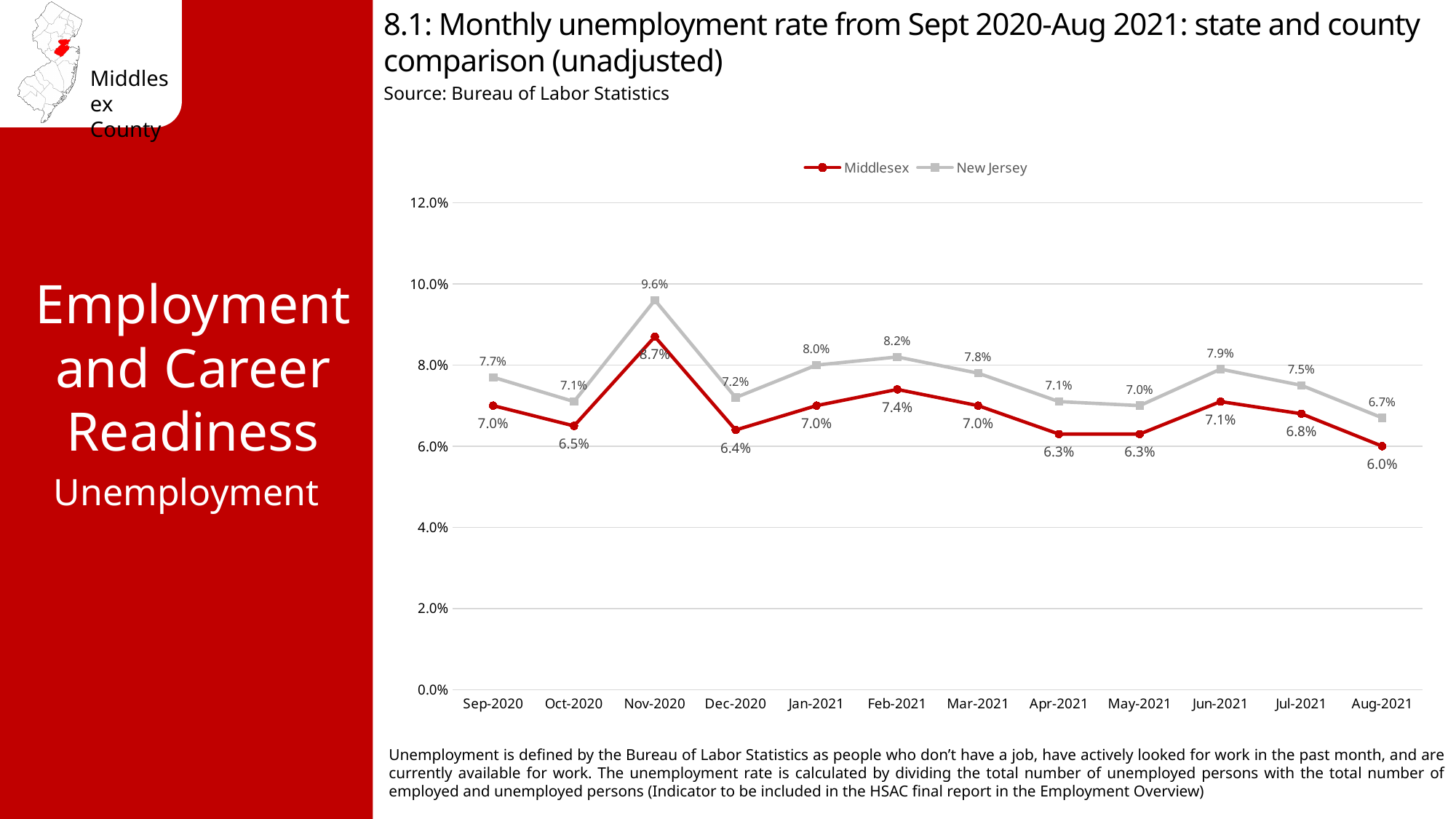
In which month does the New Jersey unemployment rate reach its highest value? Nov-2020 Is the New Jersey unemployment rate in Nov-2020 greater or less than 8.0%? greater What is the unemployment rate for Middlesex in Feb-2021? 7.4% How many months are shown on the x axis? 12 What is the unemployment rate for New Jersey in Jan-2021? 8.0% Does the Middlesex unemployment rate rise or fall from Jun-2021 to Aug-2021? Fall What is the unemployment rate for Middlesex in Aug-2021? 6.0% Which series has the higher unemployment rate in Mar-2021, Middlesex or New Jersey? New Jersey What is the difference between the New Jersey and Middlesex unemployment rates in Sep-2020? 0.7% What type of chart is shown on the slide? Line chart How many series does the legend list? 2 In which month is the Middlesex unemployment rate lowest? Aug-2021